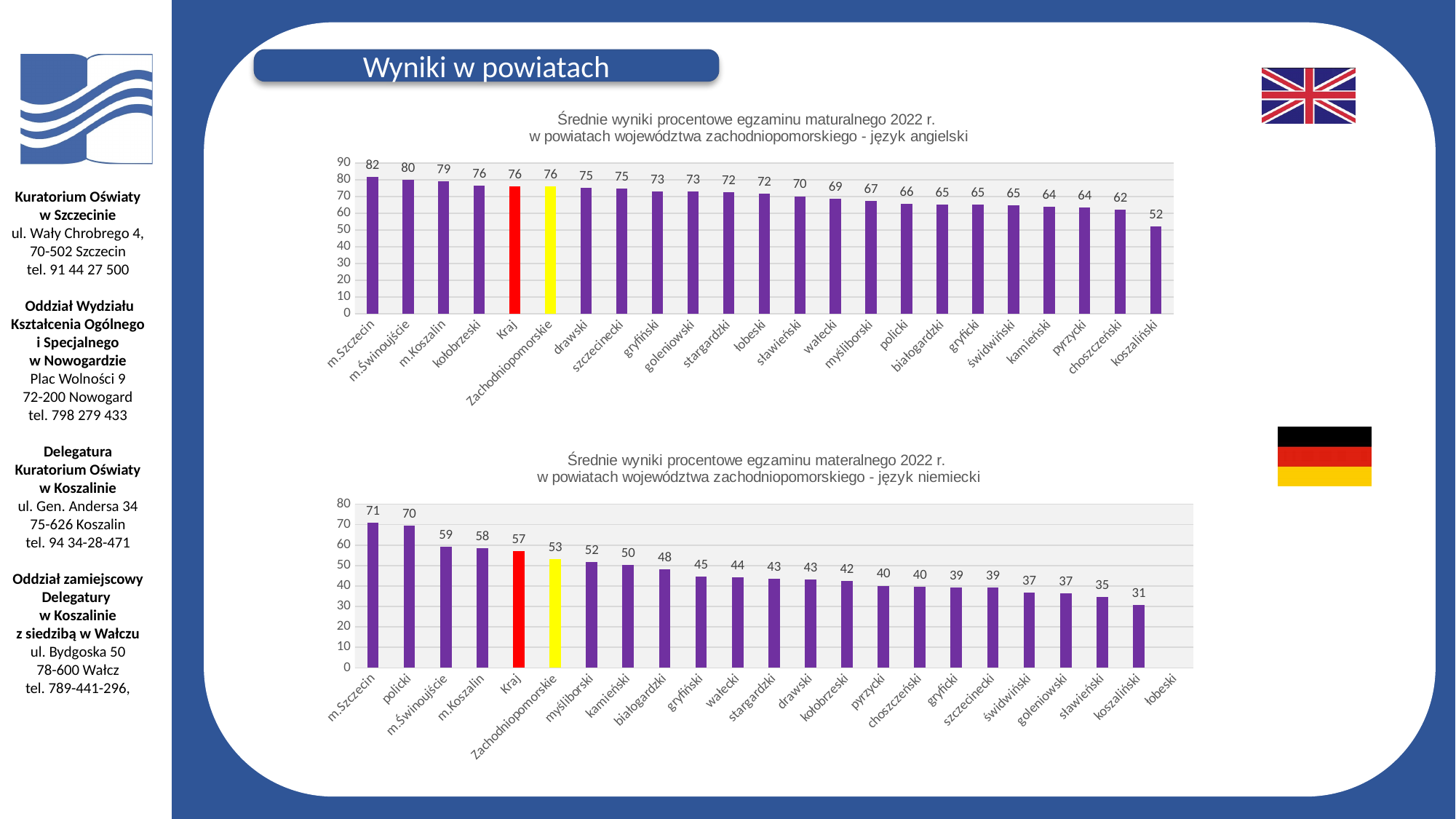
In the top chart (język angielski), which is larger, the value for policki or the value for wałecki? wałecki What kind of chart is the bottom chart (język niemiecki)? bar chart In the top chart (język angielski), what is the difference between m.Szczecin and Kraj? 6 In the top chart (język angielski), what is the value for m.Szczecin? 82 In the top chart (język angielski), do the values rise or fall from left to right? fall In the top chart (język angielski), what is the value for koszaliński? 52 In the bottom chart (język niemiecki), what is the difference between Kraj and Zachodniopomorskie? 4 In the bottom chart (język niemiecki), which category has the highest value? m.Szczecin In the bottom chart (język niemiecki), what is the value for koszaliński? 31 In the top chart (język angielski), what colour is the bar for Kraj? red In the bottom chart (język niemiecki), what is the value for policki? 70 In the top chart (język angielski), which category has the lowest value? koszaliński